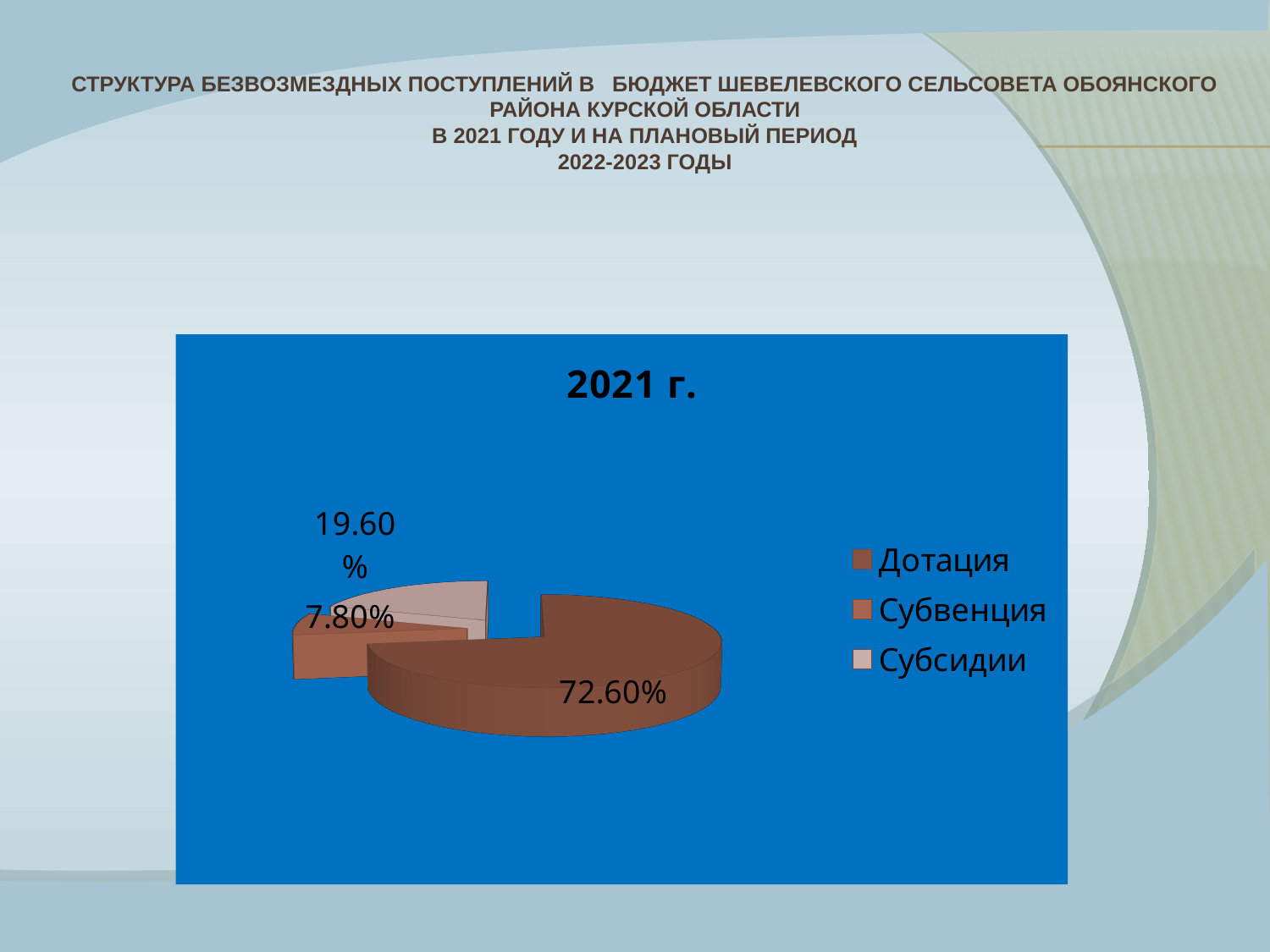
What is the difference between the share for Дотация and the share for Субсидии? 53.00% What share of the pie does Дотация have? 72.60% How many slices does the pie chart have? 3 What share of the pie does Субвенция have? 7.80% What share of the pie does Субсидии have? 19.60% Which category has the largest share of the pie? Дотация Which is larger, the share for Субсидии or the share for Субвенция? Субсидии Is the share for Дотация greater or less than 50%? greater Which category has the smallest share of the pie? Субвенция What kind of chart is shown on the slide? pie chart How many entries does the chart legend list? 3 What is the title of the chart? 2021 г.